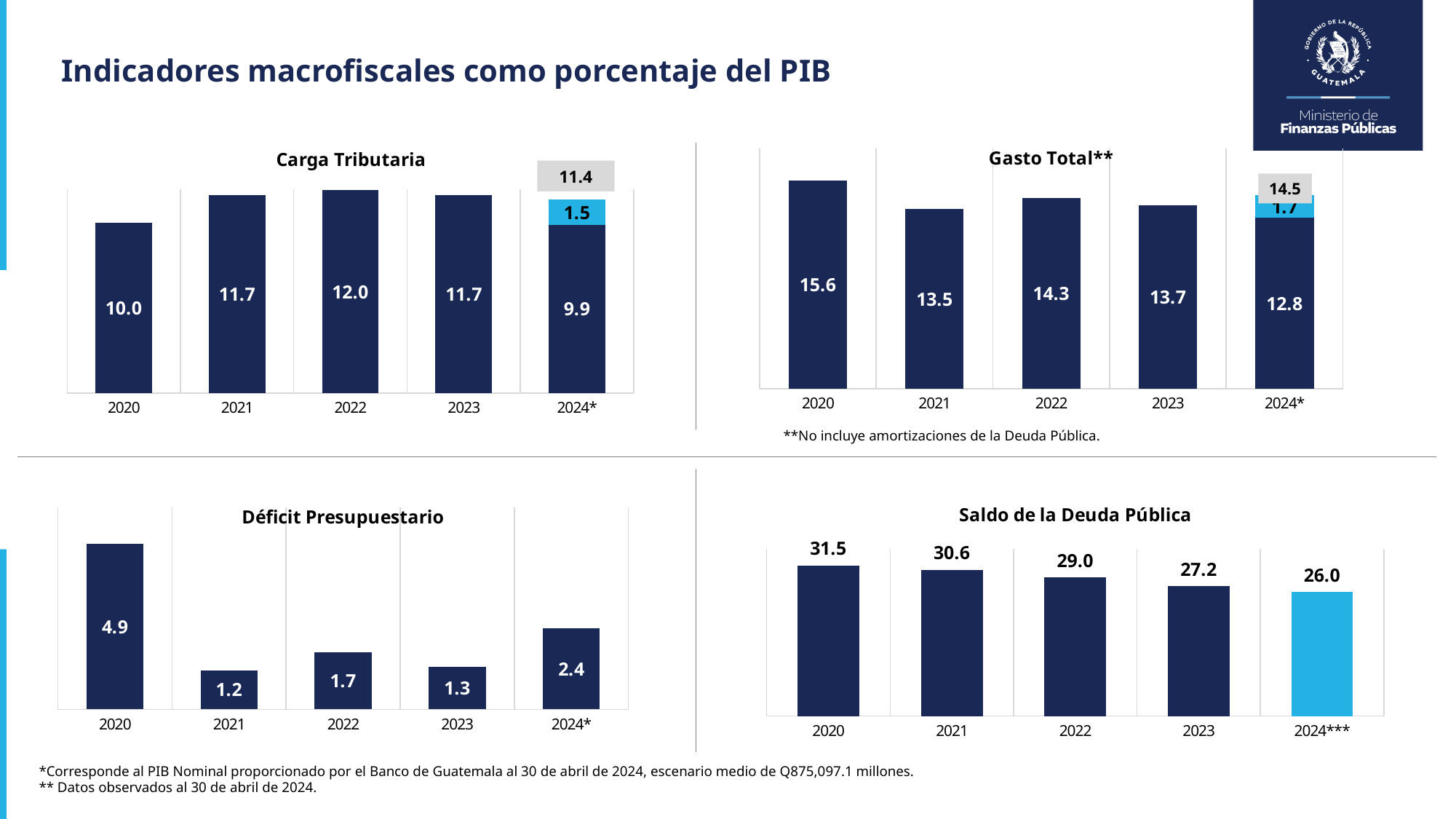
In the Carga Tributaria chart, what is the total of the stacked bar for 2024*? 11.4 What kind of chart is the Déficit Presupuestario chart? bar chart How many years are shown on the x axis of the Saldo de la Deuda Pública chart? 5 In the Saldo de la Deuda Pública chart, what is the difference between the values for 2020 and 2024***? 5.5 In the Saldo de la Deuda Pública chart, do the values rise or fall from 2020 to 2024***? fall In the Déficit Presupuestario chart, which year has the lowest value? 2021 In the Gasto Total** chart, what is the value for 2021? 13.5 In the Déficit Presupuestario chart, which is larger, the value for 2022 or the value for 2023? 2022 In the Déficit Presupuestario chart, what is the value for 2024*? 2.4 In the Gasto Total** chart, which year has the highest value? 2020 In the Carga Tributaria chart, what is the value for 2022? 12.0 In the Gasto Total** chart, what is the difference between the values for 2020 and 2023? 1.9